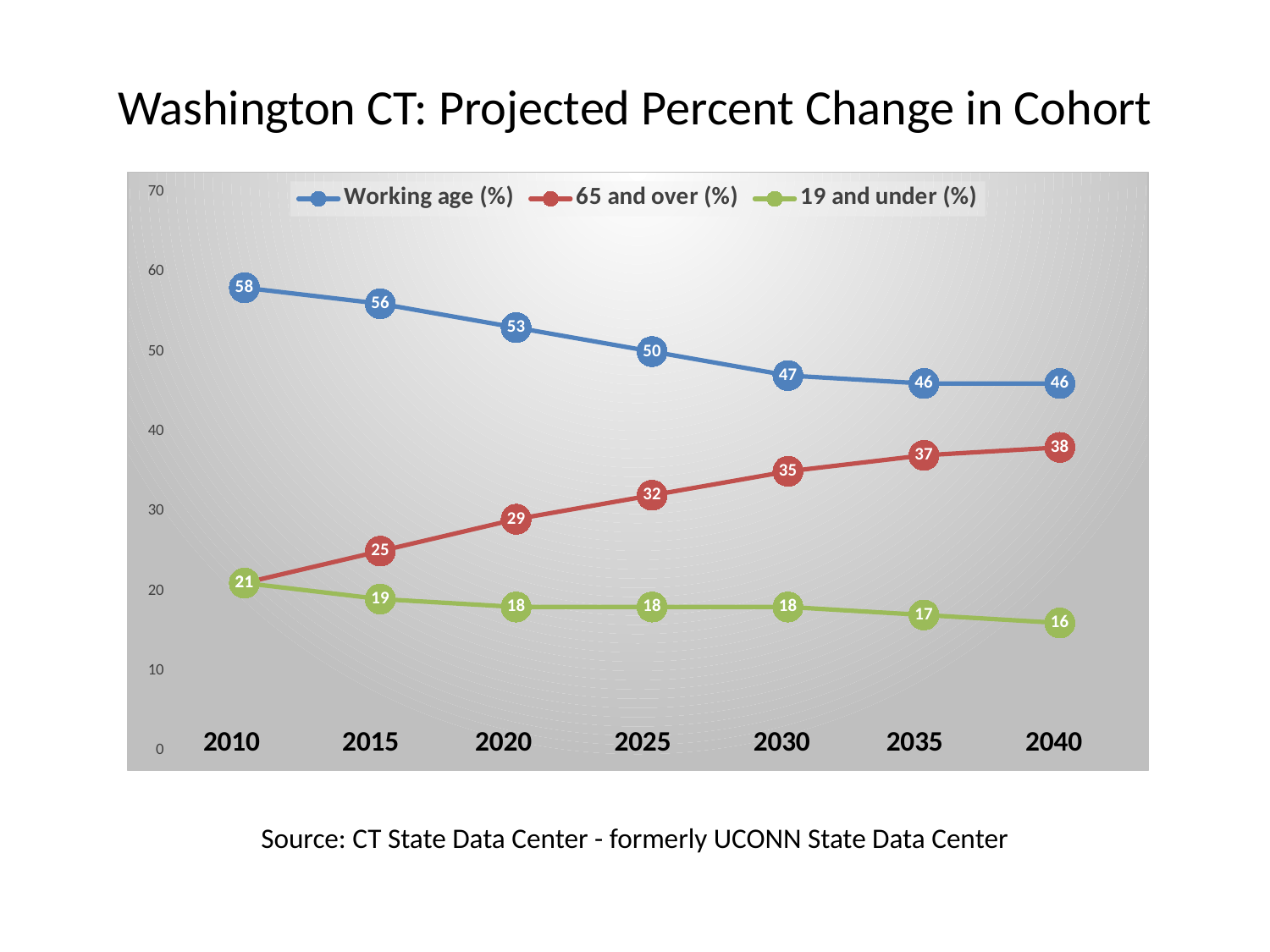
In which year is the 65 and over (%) series lowest? 2010 What kind of chart is shown? line chart How many series does the legend list? 3 What is the difference between the Working age (%) value in 2010 and in 2040? 12 What is the value for Working age (%) in 2010? 58 Which is larger in 2030: 65 and over (%) or 19 and under (%)? 65 and over (%) Does the 65 and over (%) series rise or fall from 2010 to 2040? rise In which year is the Working age (%) series highest? 2010 What is the value for 65 and over (%) in 2040? 38 Is the value for Working age (%) in 2025 greater or less than 40? greater What is the value for 19 and under (%) in 2025? 18 How many years are shown on the x axis? 7